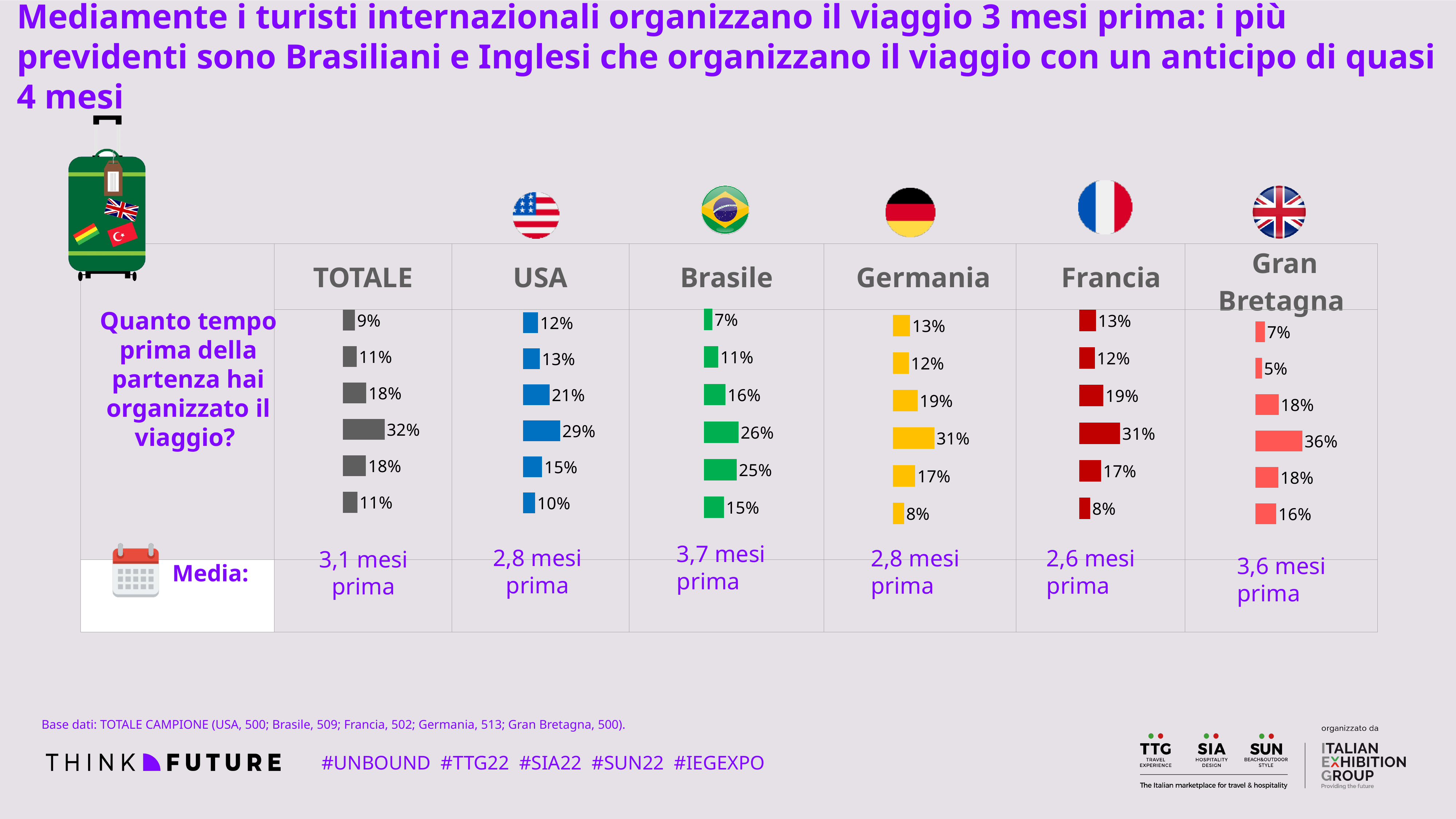
Across all six charts, which column contains the single highest bar value? Gran Bretagna In the TOTALE chart, what is the value of the fourth bar from the top? 32% How many bars are plotted in the USA chart? 6 In the Francia chart, what is the value of the last (bottom) bar? 8% What is the difference between the largest bar in the Gran Bretagna chart (36%) and the largest bar in the Francia chart (31%)? 5 percentage points What kind of chart is used in the TOTALE column to show the distribution of answers? bar chart How many separate bar charts are shown on the slide, including TOTALE? 6 What is the 'Media' value shown under the Brasile chart? 3,7 mesi prima In the Gran Bretagna chart, what is the value of the largest bar? 36% Which is larger: the fourth bar from the top in the USA chart or the fourth bar from the top in the Germania chart? Germania What colour are the bars in the Germania chart? yellow In the Brasile chart, what is the value of the smallest bar? 7%